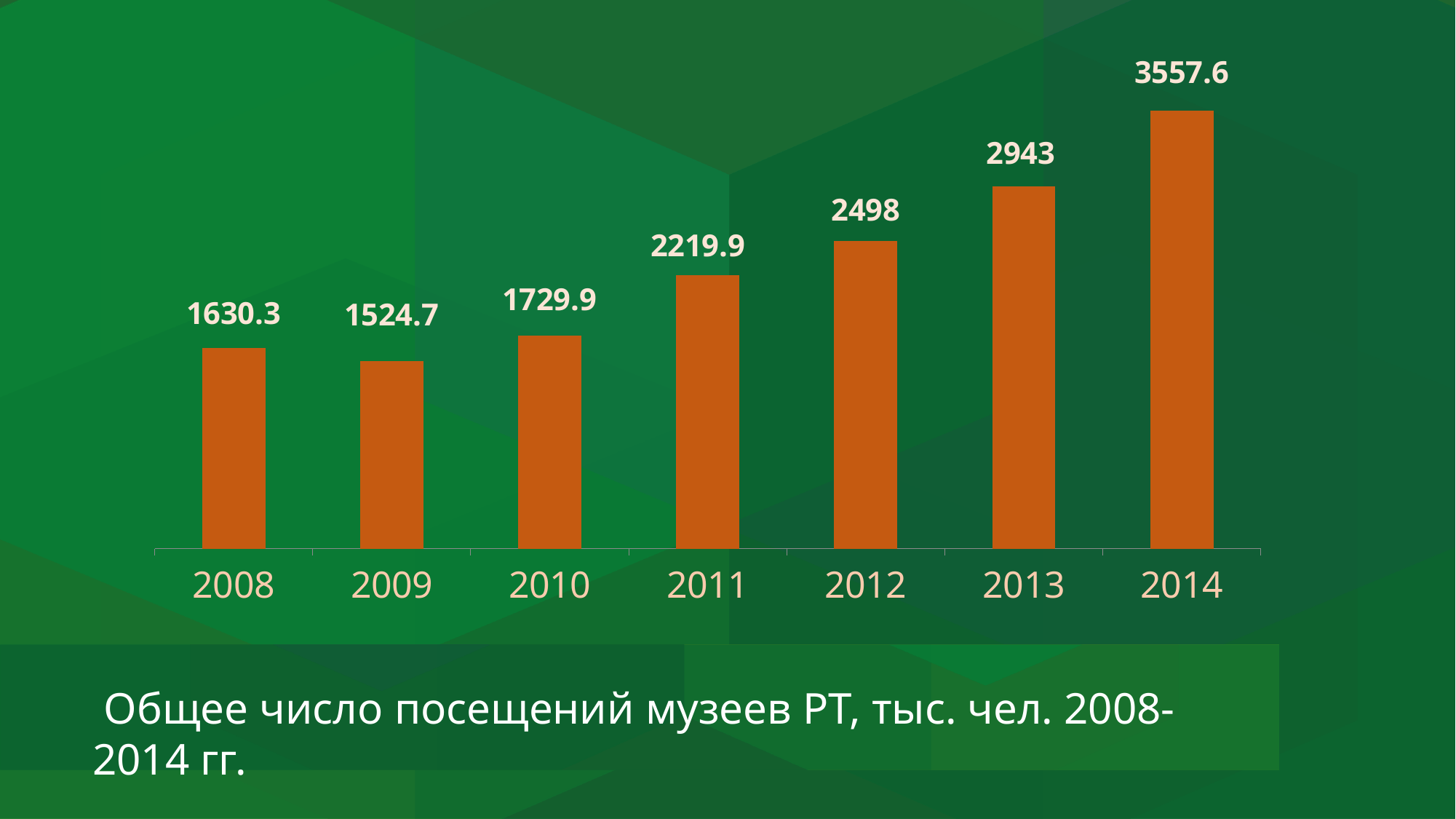
What is the difference between the values for 2014 and 2013? 614.6 Which is larger, the value for 2010 or the value for 2012? 2012 What is the value for 2011? 2219.9 What is the difference between the values for 2008 and 2009? 105.6 What kind of chart is shown on the slide? bar chart What is the value for 2014? 3557.6 Do the values generally rise or fall from 2009 to 2014? rise What is the value for 2008? 1630.3 Which year has the lowest value? 2009 What colour are the bars? orange Which year has the highest value? 2014 How many years are shown on the x axis? 7